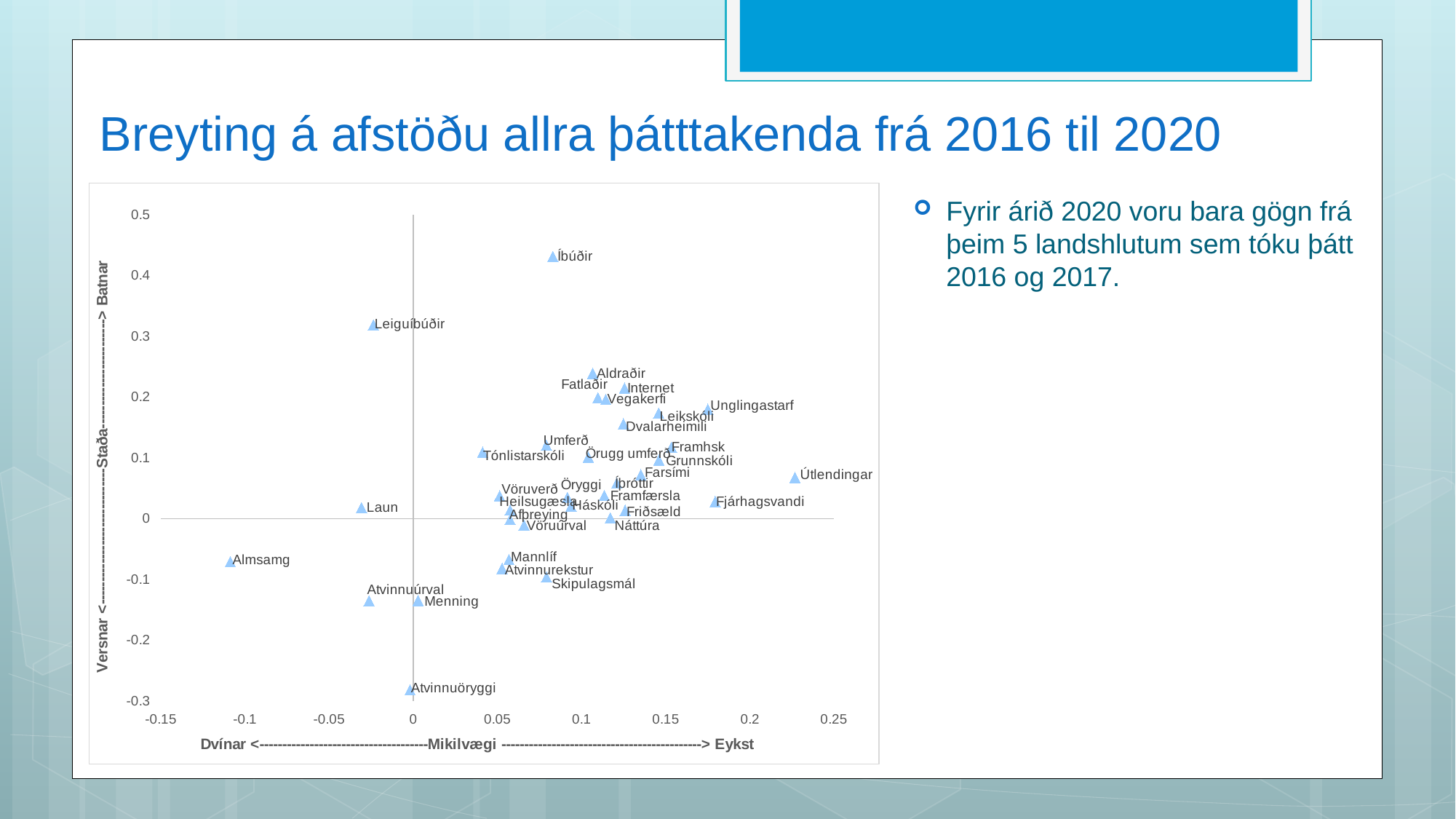
Is the vertical-axis value for Atvinnuöryggi greater or less than -0.2? less Which labeled point lies furthest to the left on the horizontal axis? Almsamg Is the vertical-axis value for Leiguíbúðir greater or less than 0.3? greater Is the horizontal-axis value for Útlendingar greater or less than 0.2? greater Which labeled point has the lowest value on the vertical axis? Atvinnuöryggi Which labeled point lies furthest to the right on the horizontal axis? Útlendingar Which point is higher on the vertical axis, Íbúðir or Leiguíbúðir? Íbúðir What is the label of the horizontal axis of the chart? Dvínar <-------------------------------------Mikilvægi ------------------------------------------> Eykst Which labeled point has the highest value on the vertical axis? Íbúðir What kind of chart is shown on the slide? scatter chart